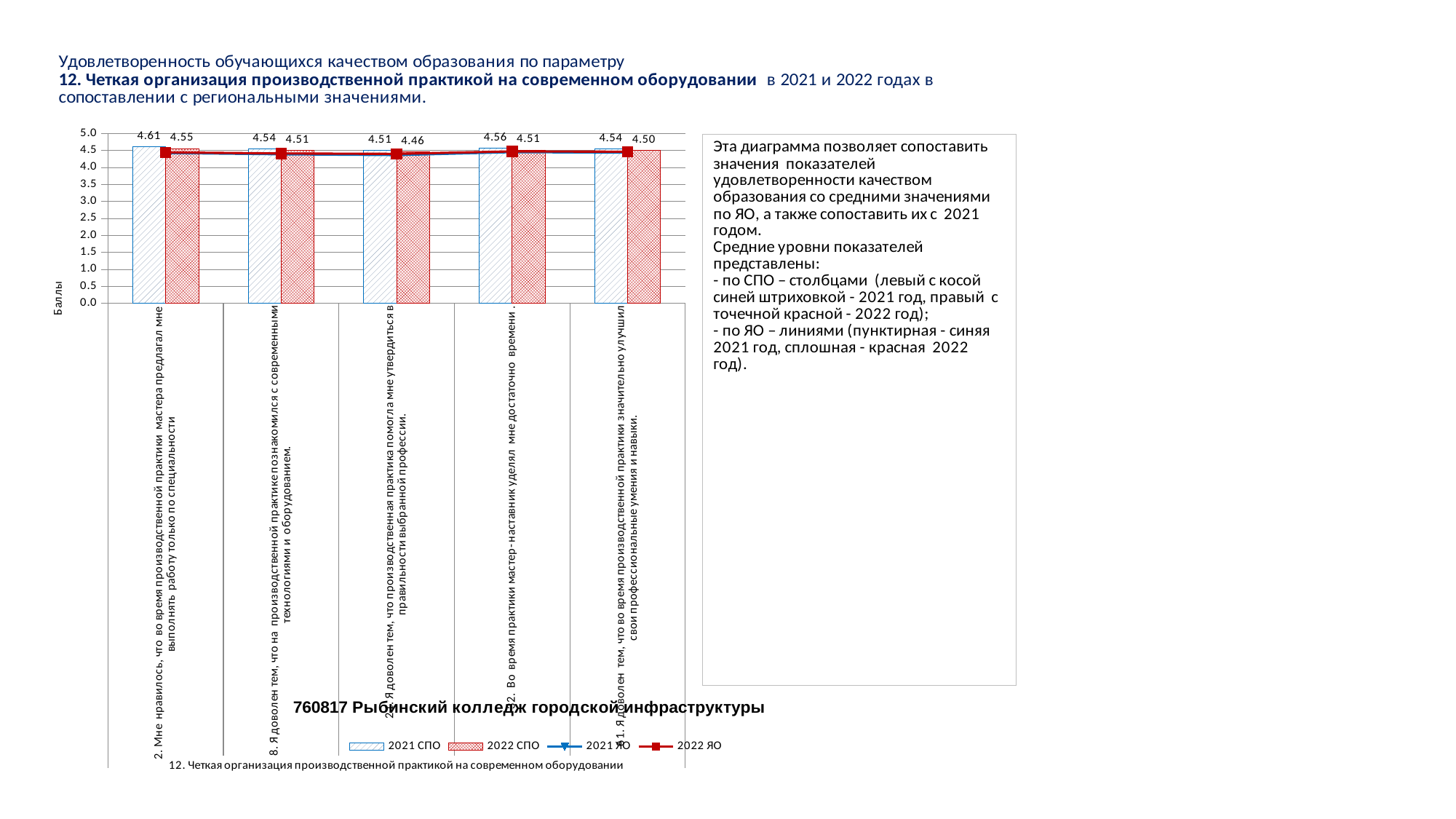
What type of chart is shown on the slide? Combined bar and line chart How many categories (questions) are plotted along the x axis? 5 How many series does the chart legend list? 4 Which category has the lowest 2022 СПО value? 21. Я доволен тем, что производственная практика помогла мне утвердиться в правильности выбранной профессии What is the difference between the 2021 СПО and 2022 СПО values for category 2? 0.06 What is the 2022 СПО value for category 31 ("Я доволен тем, что во время производственной практики значительно улучшил свои профессиональные умения и навыки")? 4.50 What is the label of the vertical axis? Баллы Is the 2022 СПО value for category 8 greater or less than 4.0? greater What is the 2021 СПО value for category 2 ("Мне нравилось, что во время производственной практики мастер предлагал мне выполнять работу только по специальности")? 4.61 Which category has the highest 2021 СПО value? 2. Мне нравилось, что во время производственной практики мастер предлагал мне выполнять работу только по специальности What is the 2022 СПО value for category 20 ("Я доволен тем, что производственная практика помогла мне утвердиться в правильности выбранной профессии")? 4.46